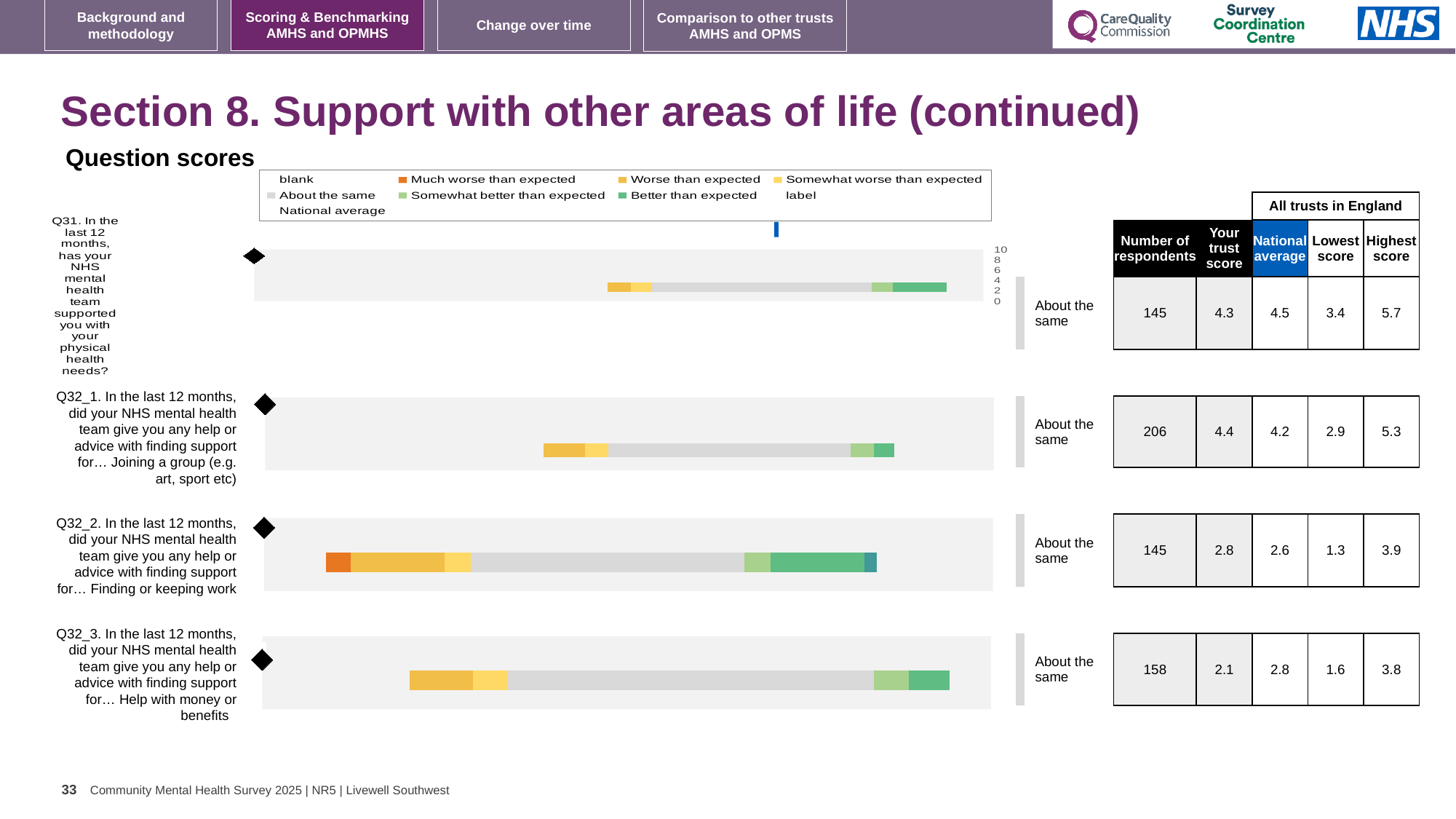
What type of chart is used to show the question scores on this slide? bar chart Which question has the lowest 'Your trust score'? Q32_3 (Help with money or benefits) Which question has the highest 'Your trust score'? Q32_1 (Joining a group) For Q32_2 (Finding or keeping work), what is the difference between the highest score and the lowest score across all trusts in England? 2.6 How many respondents are shown for Q32_1 (Joining a group)? 206 What is the 'Your trust score' value for Q32_2 (Finding or keeping work)? 2.8 What is the national average for Q31 (support with physical health needs)? 4.5 What benchmark category label is shown next to the bar for Q32_1 (Joining a group)? About the same How many questions are plotted in the question scores chart? 4 What is the highest score across all trusts in England for Q31? 5.7 What is the lowest score across all trusts in England for Q32_3 (Help with money or benefits)? 1.6 For Q32_3 (Help with money or benefits), which is larger: the trust score or the national average? National average